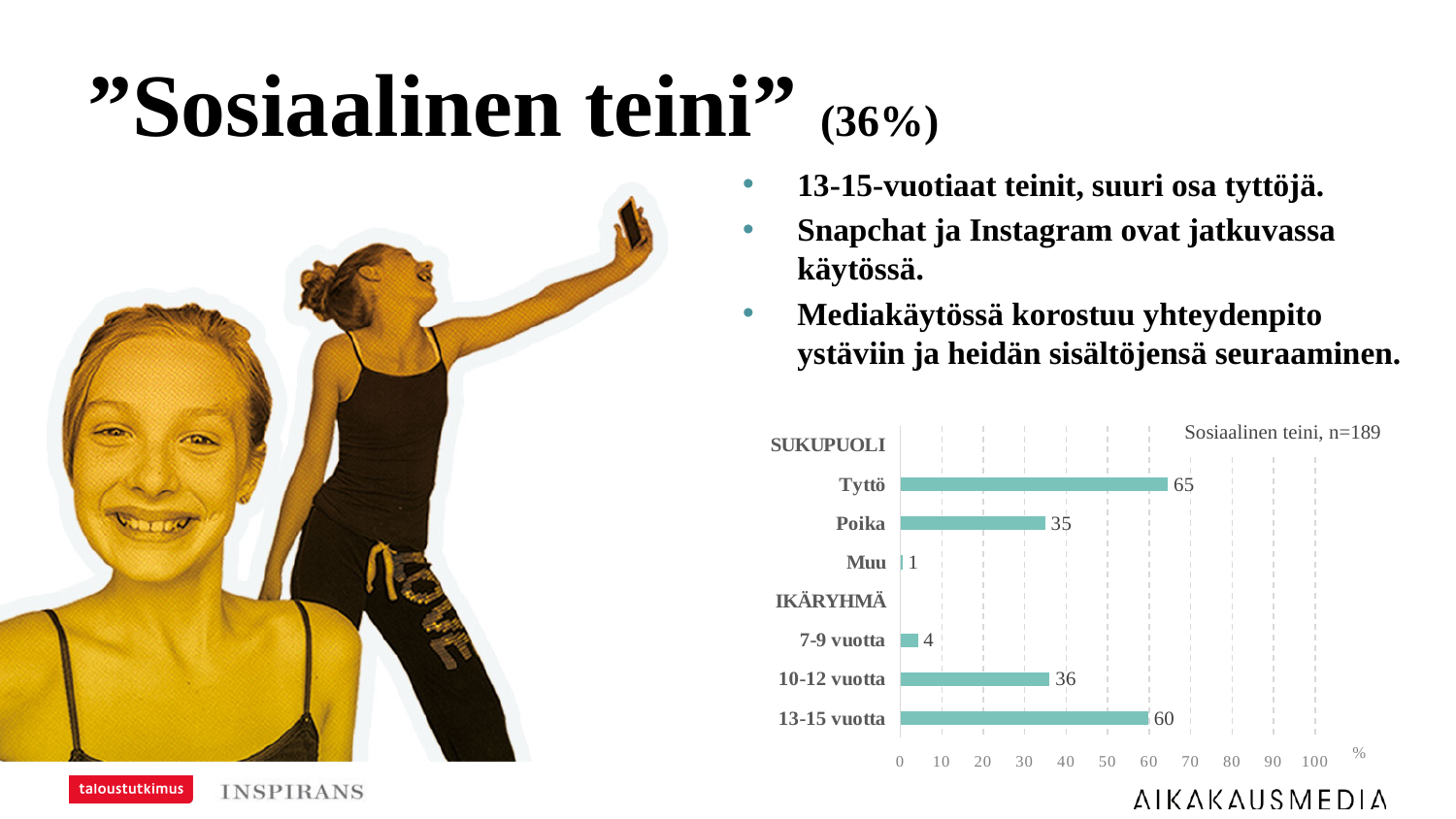
Which category in the SUKUPUOLI group has the lowest value? Muu What is the value for 7-9 vuotta in the chart? 4 What is the value for 13-15 vuotta in the chart? 60 Which is larger, the value for 10-12 vuotta or the value for Poika? 10-12 vuotta What is the difference between the values for 13-15 vuotta and 10-12 vuotta? 24 What is the value for Poika in the chart? 35 What kind of chart is shown on the slide? bar chart Which age group (IKÄRYHMÄ) has the highest value? 13-15 vuotta What is the value for Tyttö in the chart? 65 What is the sample size (n) stated in the chart? n=189 What is the difference between the values for Tyttö and Poika? 30 How many data bars are plotted in the chart? 6